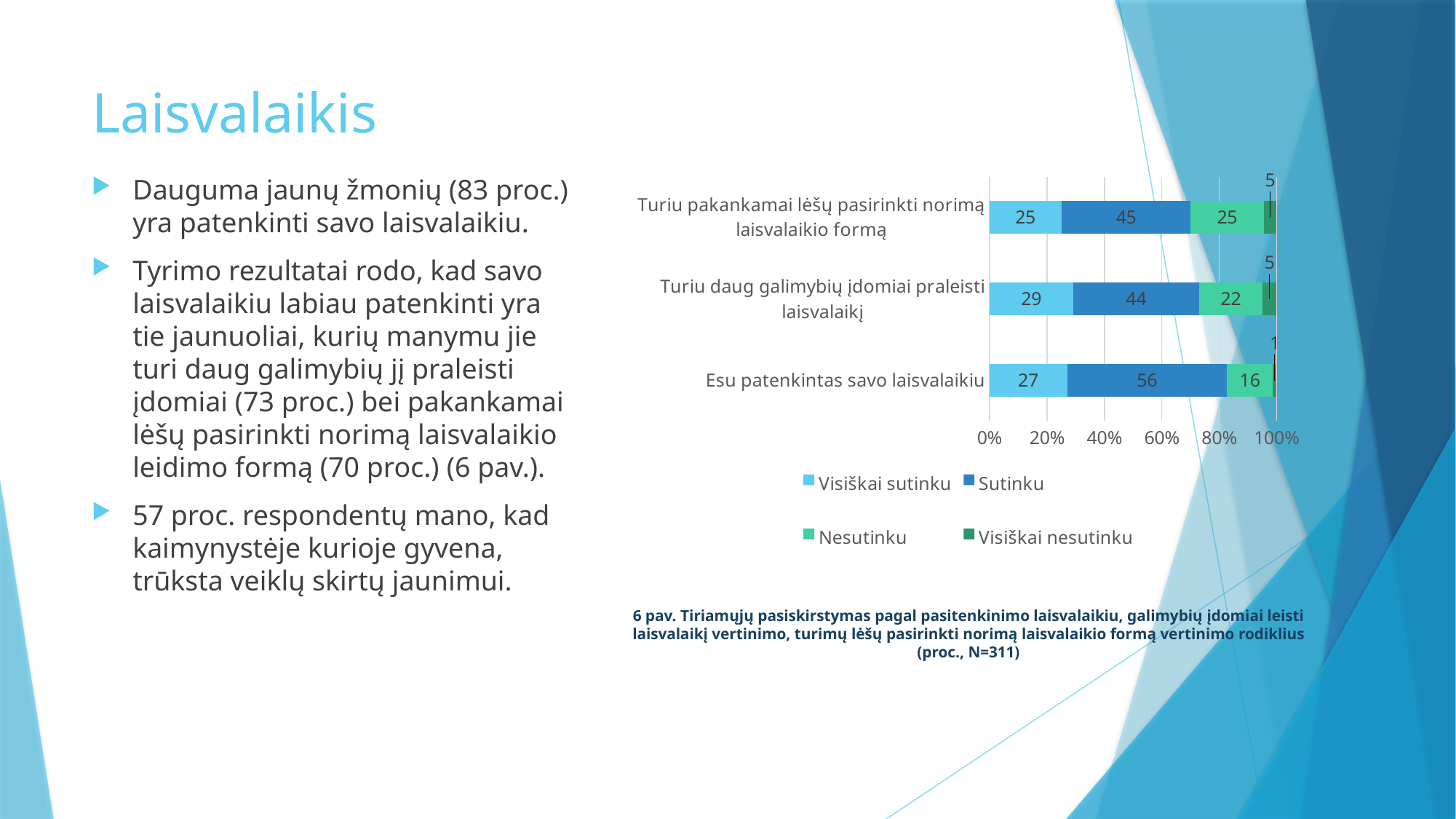
What is the value of "Visiškai nesutinku" for "Esu patenkintas savo laisvalaikiu"? 1 What is the value of "Sutinku" for "Esu patenkintas savo laisvalaikiu"? 56 What kind of chart is shown on the slide? stacked bar chart Which category has the lowest "Nesutinku" value? Esu patenkintas savo laisvalaikiu What is the difference between the "Sutinku" values for "Esu patenkintas savo laisvalaikiu" and "Turiu daug galimybių įdomiai praleisti laisvalaikį"? 12 What is the value of "Nesutinku" for "Turiu pakankamai lėšų pasirinkti norimą laisvalaikio formą"? 25 Which category has the highest "Sutinku" value? Esu patenkintas savo laisvalaikiu Which legend entry is shown in the darkest green colour? Visiškai nesutinku What is the value of "Visiškai sutinku" for "Turiu daug galimybių įdomiai praleisti laisvalaikį"? 29 How many categories are plotted on the chart? 3 How many series does the chart legend list? 4 Which is larger: the "Visiškai sutinku" value for "Turiu daug galimybių įdomiai praleisti laisvalaikį" or for "Turiu pakankamai lėšų pasirinkti norimą laisvalaikio formą"? Turiu daug galimybių įdomiai praleisti laisvalaikį